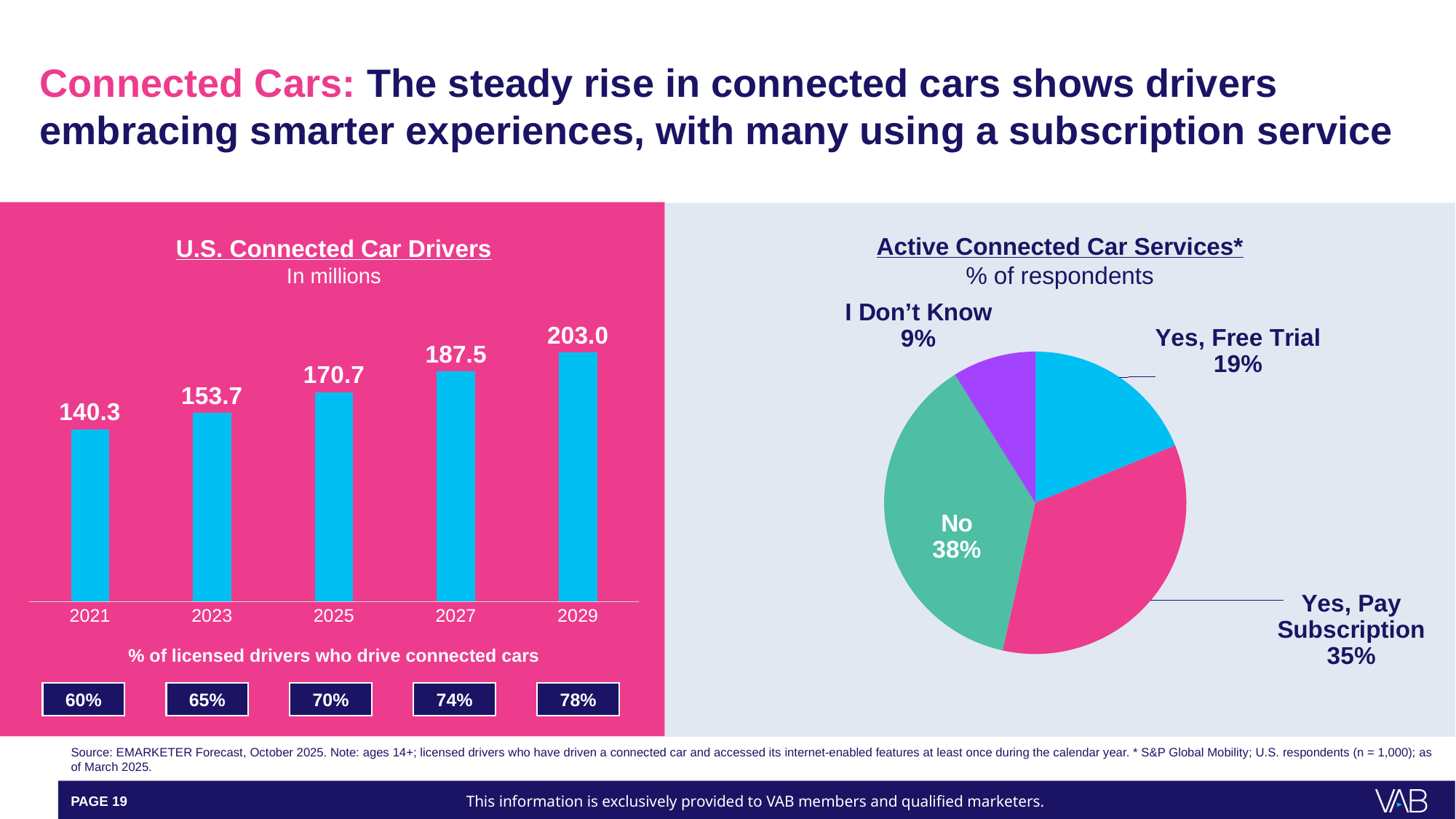
In the 'Active Connected Car Services' pie chart, how many slices are there? 4 In the 'Active Connected Car Services' pie chart, which response has the largest share? No In the 'U.S. Connected Car Drivers' chart, which year has the lowest value? 2021 In the 'U.S. Connected Car Drivers' chart, what is the value for 2025? 170.7 In the 'Active Connected Car Services' pie chart, which is larger: 'Yes, Free Trial' or 'I Don't Know'? Yes, Free Trial In the 'U.S. Connected Car Drivers' chart, what is the value for 2029? 203.0 In the 'U.S. Connected Car Drivers' chart, what percentage of licensed drivers drive connected cars in 2027? 74% In the 'U.S. Connected Car Drivers' chart, do the values rise or fall from 2021 to 2029? rise What kind of chart is the 'U.S. Connected Car Drivers' chart? bar chart In the 'Active Connected Car Services' pie chart, what share of respondents answered 'Yes, Pay Subscription'? 35% In the 'U.S. Connected Car Drivers' chart, what is the difference between the 2029 and 2021 values? 62.7 In the 'U.S. Connected Car Drivers' chart, how many years are plotted? 5